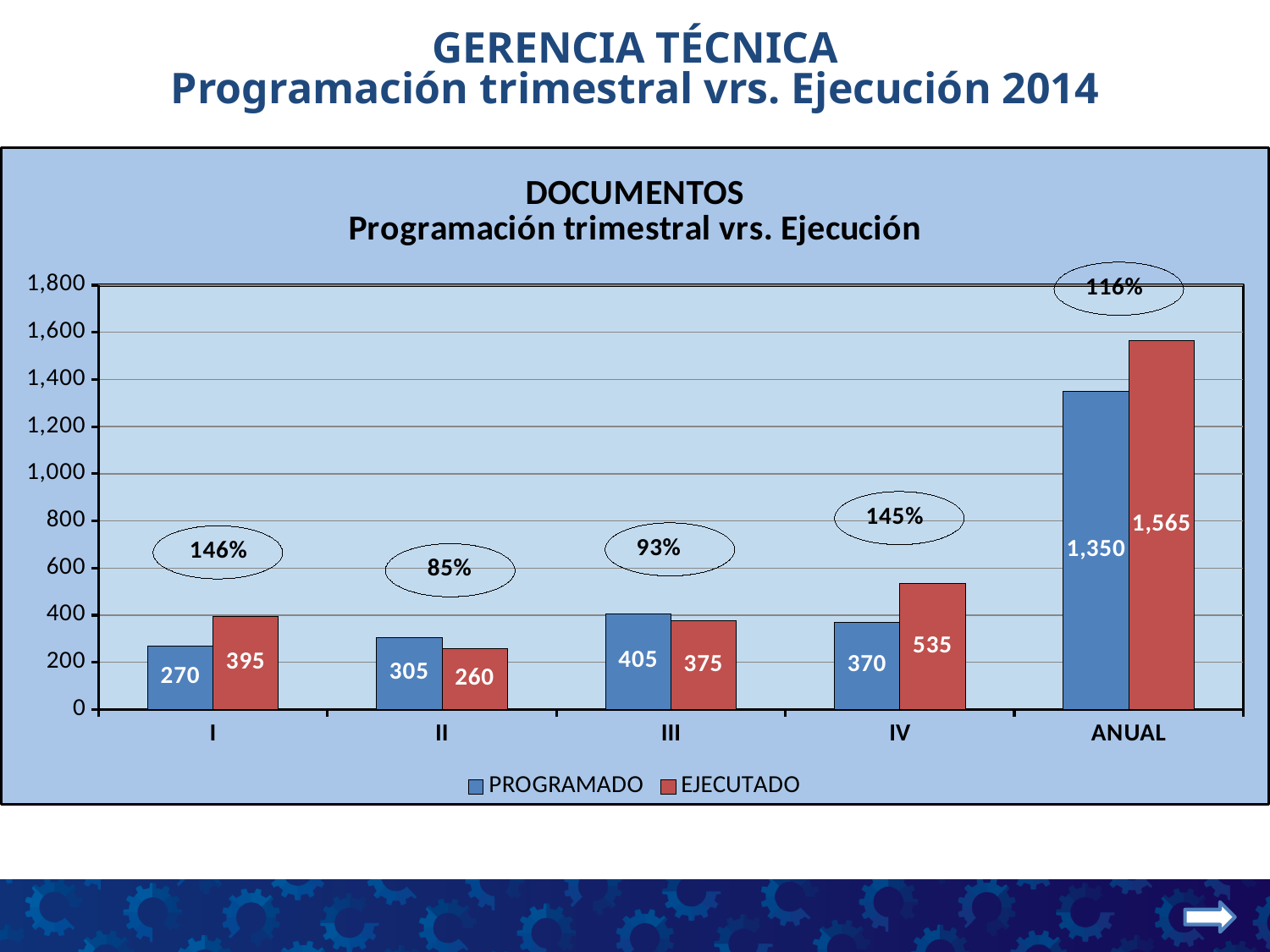
What kind of chart is shown? bar chart How many categories are shown on the x axis? 5 Which is larger for quarter II, PROGRAMADO or EJECUTADO? PROGRAMADO Is the EJECUTADO value for ANUAL greater or less than 1,400? greater What is the difference between EJECUTADO and PROGRAMADO for quarter IV? 165 What percentage is shown in the circle above quarter III? 93% Which quarter (I–IV) has the highest EJECUTADO value? IV What is the EJECUTADO value for quarter IV? 535 What is the EJECUTADO value for ANUAL? 1,565 How many series does the legend list? 2 Which quarter (I–IV) has the lowest PROGRAMADO value? I What is the PROGRAMADO value for quarter I? 270